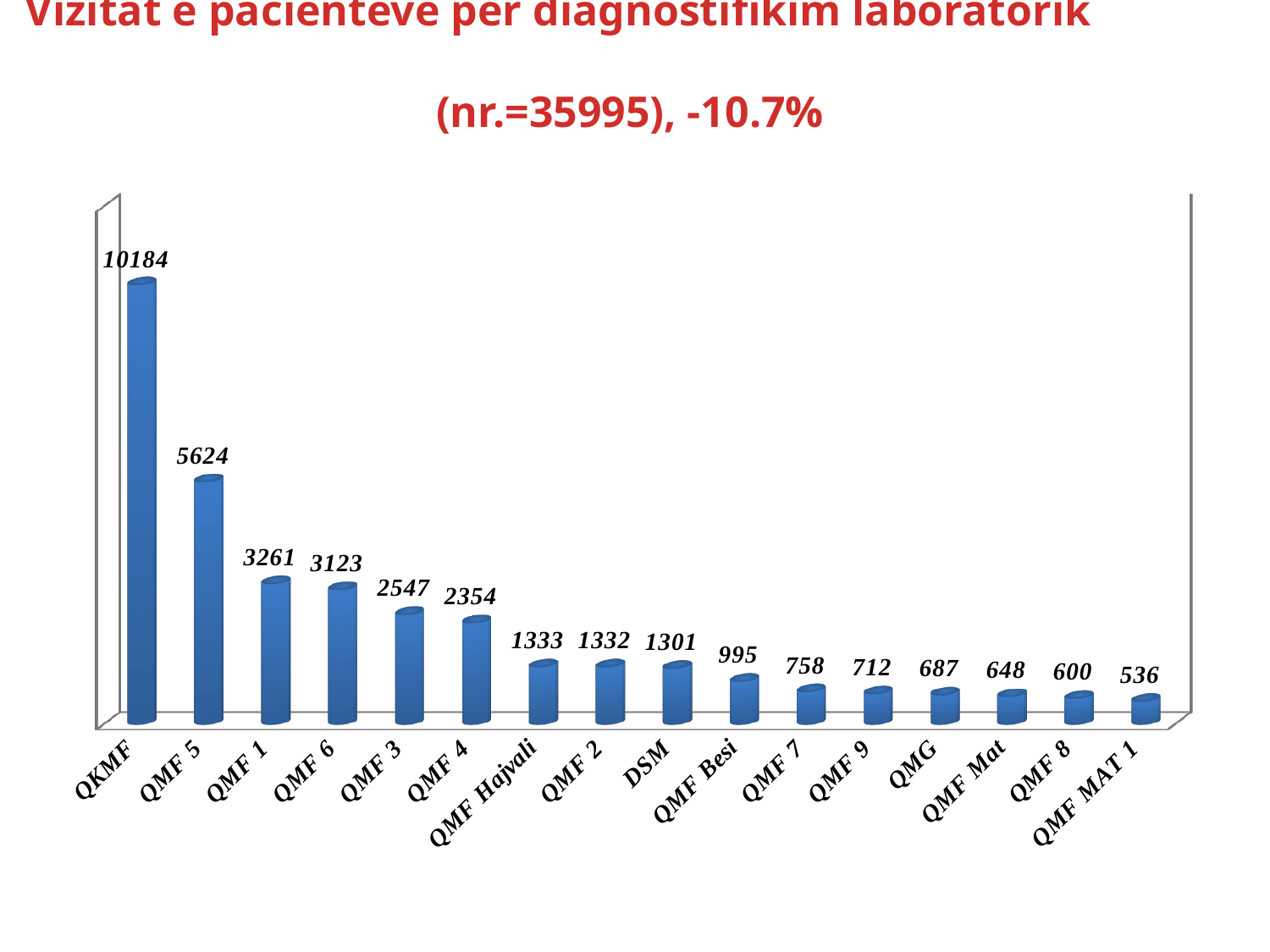
What is the difference between the values for QMF 1 and QMF 6? 138 What is the value for QMF 5? 5624 What is the value for QMF MAT 1? 536 What is the difference between the values for QKMF and QMF 5? 4560 How many categories are shown in the chart? 16 Do the values rise or fall from left to right along the x axis? Fall What is the value for QKMF? 10184 Which category has the lowest value? QMF MAT 1 What is the value for QMF Hajvali? 1333 What kind of chart is shown on the slide? Bar chart Which is larger, the value for QMF 3 or the value for QMF 4? QMF 3 Which category has the highest value? QKMF